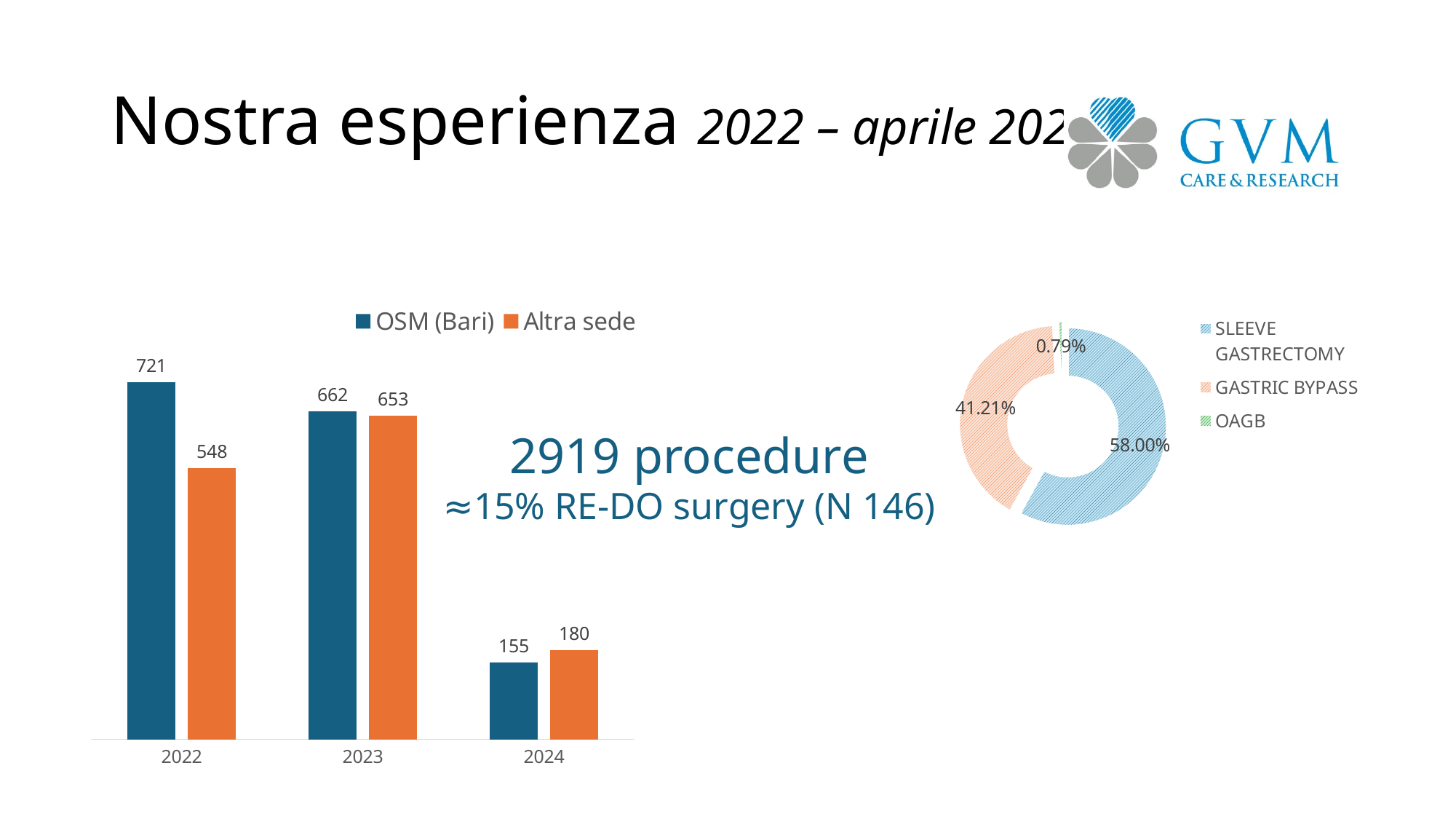
How many years are shown on the x axis of the bar chart on the left? 3 In the bar chart on the left, what is the value for Altra sede in 2023? 653 In the bar chart on the left, what is the value for Altra sede in 2024? 180 In the doughnut chart on the right, what share does GASTRIC BYPASS have? 41.21% In the bar chart on the left, what is the value for OSM (Bari) in 2022? 721 What kind of chart is the chart on the right of the slide? Doughnut (pie) chart In the bar chart on the left, which is larger in 2024, OSM (Bari) or Altra sede? Altra sede In the bar chart on the left, what is the difference between OSM (Bari) and Altra sede in 2022? 173 In the doughnut chart on the right, which category has the smallest share? OAGB How many series does the legend of the bar chart on the left list? 2 In the bar chart on the left, which year has the lowest Altra sede value? 2024 In the bar chart on the left, which year has the highest OSM (Bari) value? 2022